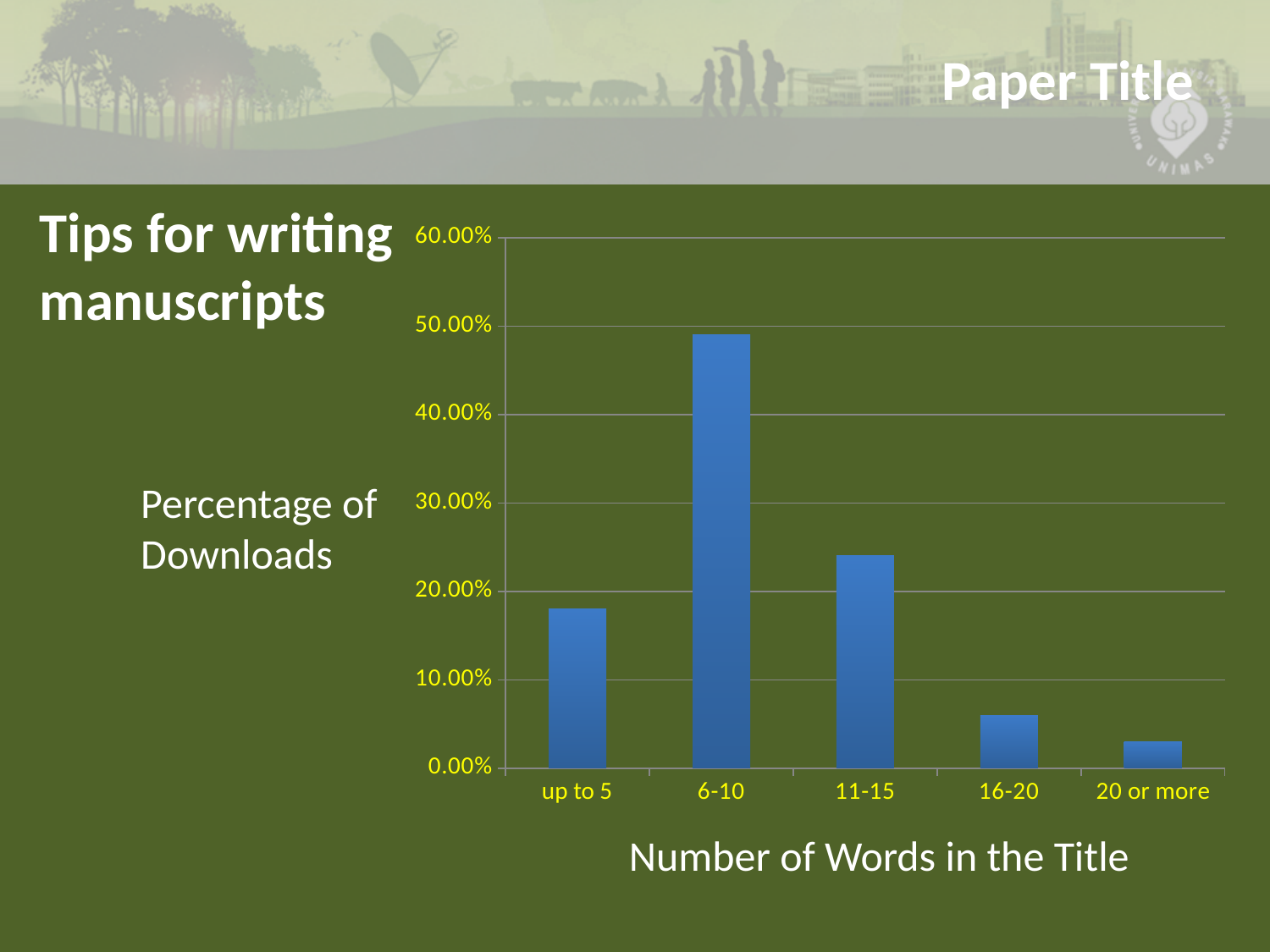
What is the label of the x axis of the chart? Number of Words in the Title Which category has the highest percentage of downloads? 6-10 Is the value for 20 or more greater or less than 10.00%? less Is the value for 11-15 greater or less than 20.00%? greater What is the label of the y axis of the chart? Percentage of Downloads What kind of chart is shown on the slide? bar chart Is the value for 6-10 greater or less than 40.00%? greater How many categories are shown on the x axis of the chart? 5 Which category has the lowest percentage of downloads? 20 or more Which has a higher percentage of downloads, up to 5 or 11-15? 11-15